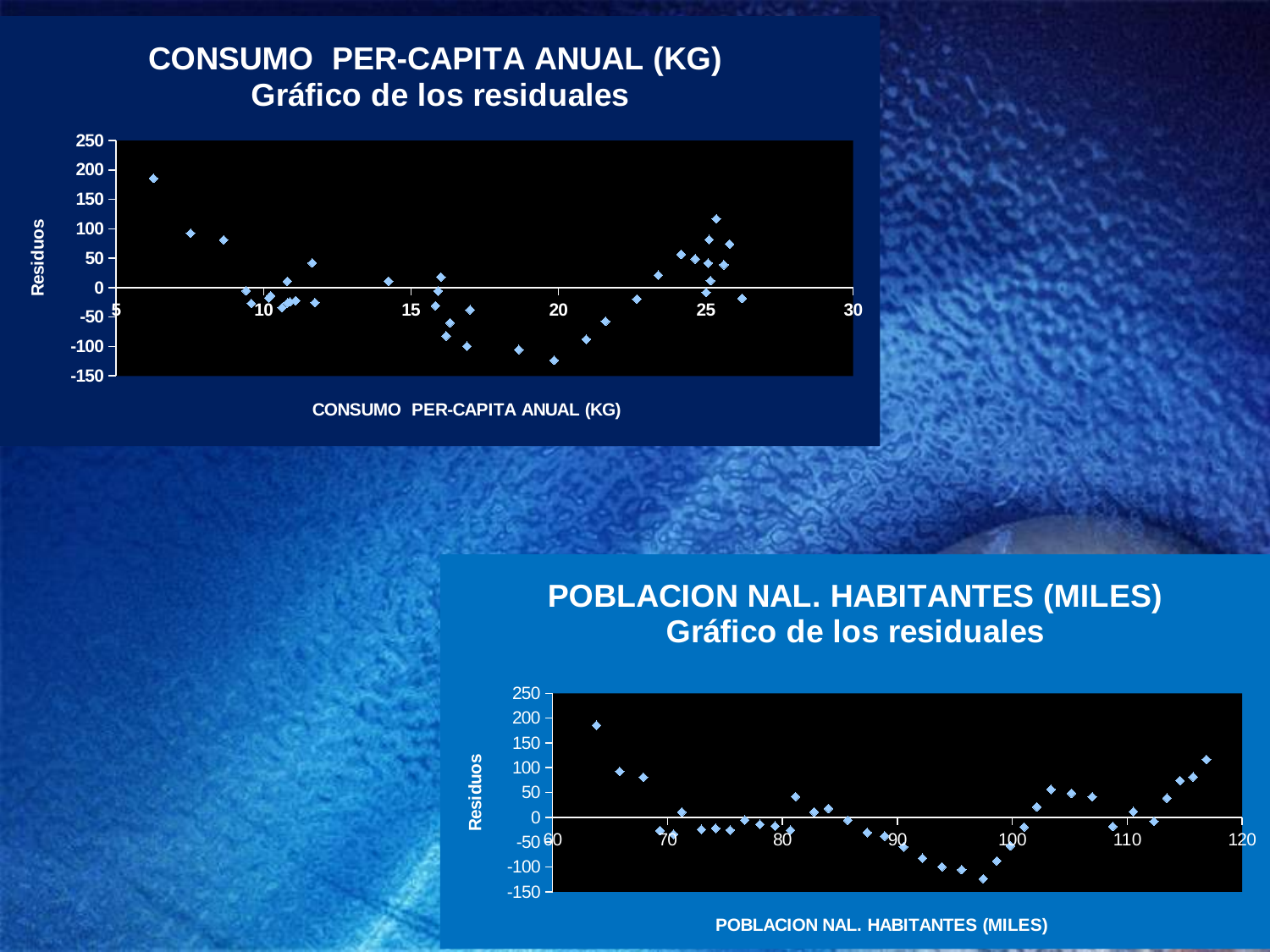
What kind of chart is the top chart titled 'CONSUMO PER-CAPITA ANUAL (KG) Gráfico de los residuales'? scatter chart In the bottom chart (POBLACION NAL. HABITANTES), is the lowest residual value greater or less than -100? less In the top chart (CONSUMO PER-CAPITA ANUAL), which has the larger residual: the leftmost point or the rightmost point? the leftmost point In the top chart (CONSUMO PER-CAPITA ANUAL), is the residual for the point near x = 20 greater or less than 0? less In the bottom chart (POBLACION NAL. HABITANTES), is the residual for the rightmost point (near x = 117) greater or less than 50? greater What kind of chart is the bottom chart titled 'POBLACION NAL. HABITANTES (MILES) Gráfico de los residuales'? scatter chart In the bottom chart, what is the title of the horizontal axis? POBLACION NAL. HABITANTES (MILES) In the top chart (CONSUMO PER-CAPITA ANUAL), what is the title of the vertical axis? Residuos In the bottom chart (POBLACION NAL. HABITANTES), which has the larger residual: the point near x = 64 or the point near x = 97? the point near x = 64